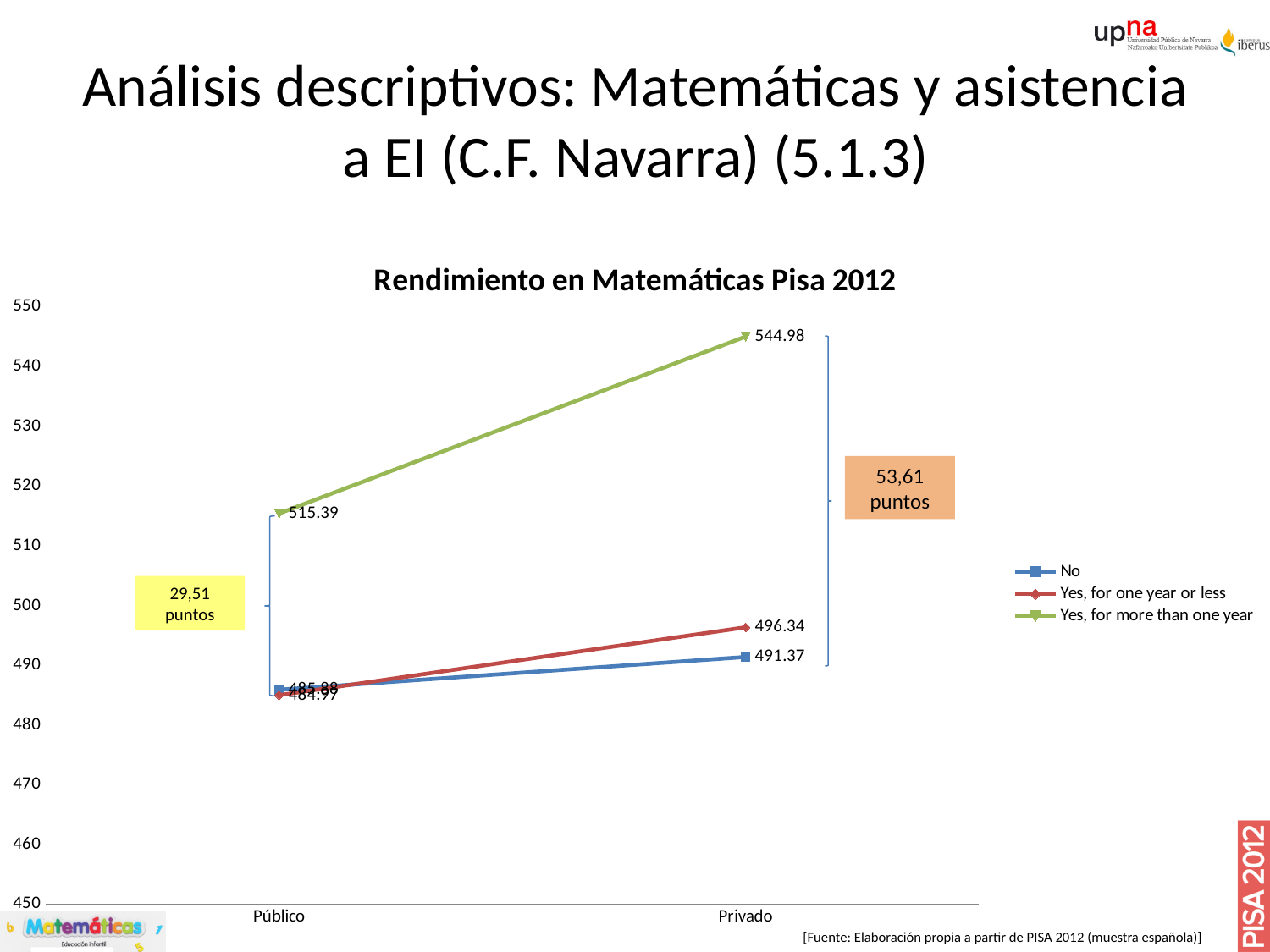
In the Privado category, what is the difference between 'Yes, for more than one year' and 'Yes, for one year or less'? 48.64 How many series does the legend list? 3 What is the value for 'Yes, for more than one year' in the Público category? 515.39 What is the value for 'Yes, for more than one year' in the Privado category? 544.98 Which series has the highest value in the Privado category? Yes, for more than one year What is the value for 'Yes, for one year or less' in the Privado category? 496.34 How many categories are shown on the x axis? 2 Is the value for the 'No' series in the Público category greater or less than 500? less What is the value for the 'No' series in the Privado category? 491.37 What is the title of the chart? Rendimiento en Matemáticas Pisa 2012 Which series has the lowest value in the Privado category? No What kind of chart is shown on the slide? line chart